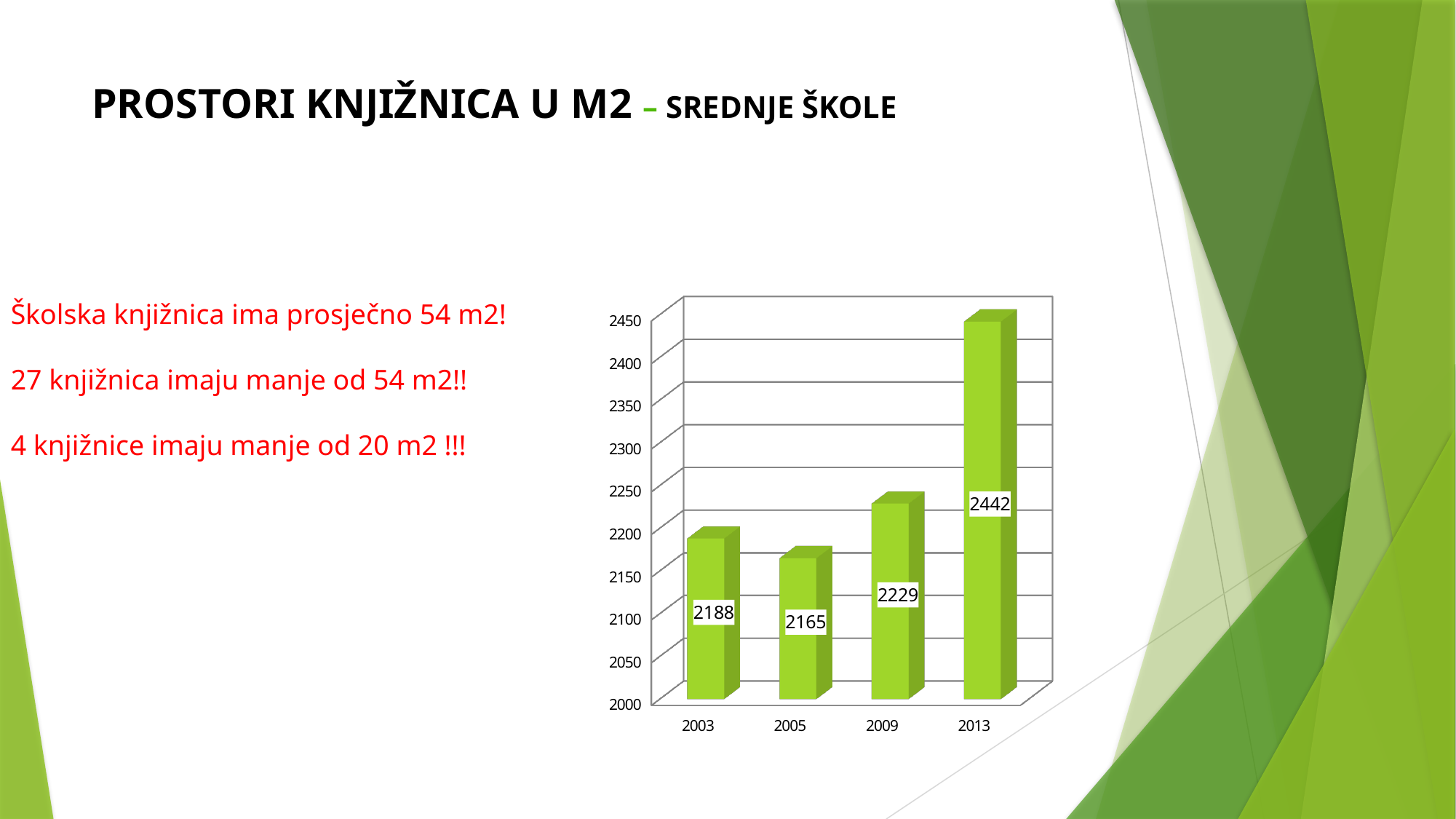
Which is larger, the value for 2003 or the value for 2009? 2009 What is the difference between the values for 2003 and 2005? 23 What kind of chart is shown on the slide? bar chart What is the value for 2009? 2229 How many years are shown on the x axis? 4 What is the value for 2013? 2442 Which year has the lowest value? 2005 Is the value for 2013 greater or less than 2400? greater What is the value for 2005? 2165 What is the difference between the values for 2013 and 2009? 213 What is the value for 2003? 2188 Which year has the highest value? 2013